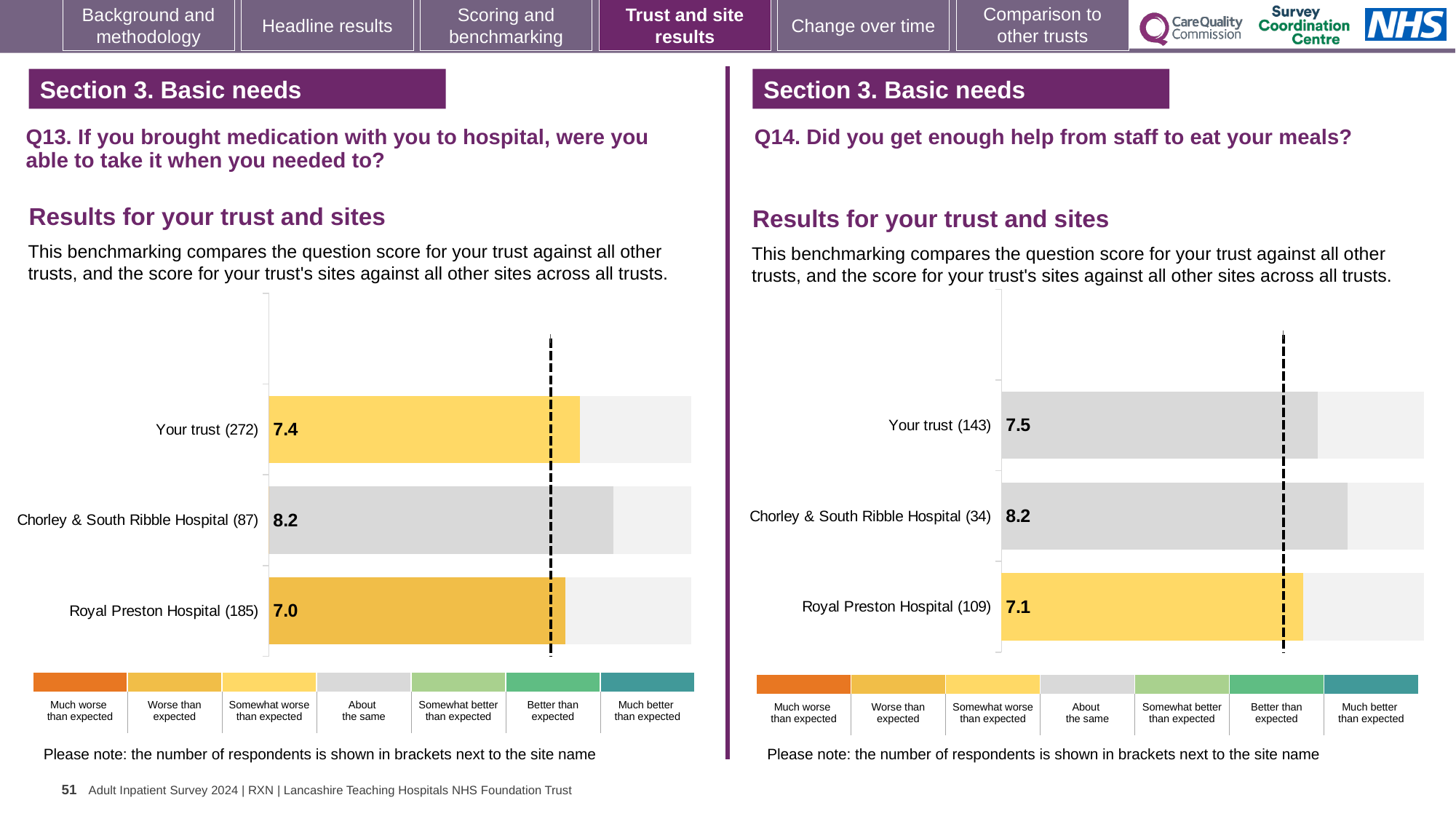
On the Q14 chart (right), what is the score for Your trust (143)? 7.5 On the Q14 chart (right), which benchmark category does the colour of the Royal Preston Hospital (109) bar correspond to in the legend? Somewhat worse than expected On the Q14 chart (right), what is the score for Chorley & South Ribble Hospital (34)? 8.2 On the Q14 chart (right), which site or trust has the lowest score? Royal Preston Hospital (109) What kind of chart is used on the Q13 chart (left)? Bar chart On the Q13 chart (left), what is the score for Royal Preston Hospital (185)? 7.0 On the Q14 chart (right), what is the difference between the scores for Chorley & South Ribble Hospital (34) and Your trust (143)? 0.7 On the Q13 chart (left), which site or trust has the highest score? Chorley & South Ribble Hospital (87) On the Q14 chart (right), which is larger: the score for Your trust (143) or Royal Preston Hospital (109)? Your trust (143) On the Q13 chart (left), how many bars are plotted? 3 On the Q13 chart (left), what is the difference between the scores for Chorley & South Ribble Hospital (87) and Royal Preston Hospital (185)? 1.2 On the Q13 chart (left), what is the score for Your trust (272)? 7.4